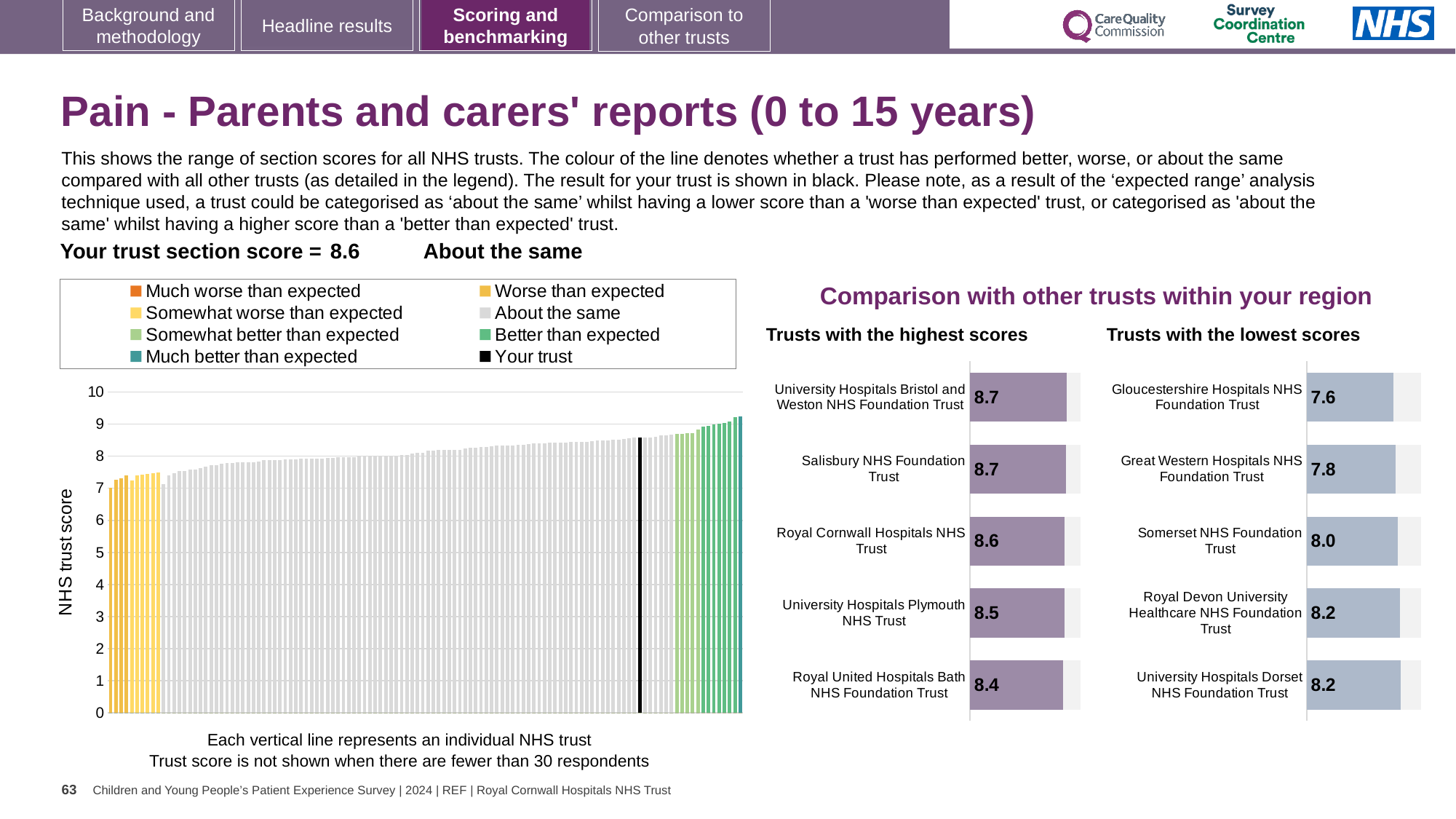
How many trusts are listed in the 'Trusts with the highest scores' chart? 5 In the 'Trusts with the highest scores' chart, what is the score for Royal United Hospitals Bath NHS Foundation Trust? 8.4 In the large chart on the left, do the trust scores rise or fall from left to right along the x axis? Rise In the 'Trusts with the lowest scores' chart, what is the score for Gloucestershire Hospitals NHS Foundation Trust? 7.6 In the large chart on the left, what is the section score for your trust (shown in black)? 8.6 In the 'Trusts with the lowest scores' chart, which trust has the lowest score? Gloucestershire Hospitals NHS Foundation Trust In the 'Trusts with the highest scores' chart, what is the difference between the score for Salisbury NHS Foundation Trust and the score for University Hospitals Plymouth NHS Trust? 0.2 What is the label on the y axis of the large chart on the left? NHS trust score How many entries does the legend above the large chart on the left list? 8 In the 'Trusts with the lowest scores' chart, which is larger: the score for Great Western Hospitals NHS Foundation Trust or the score for Somerset NHS Foundation Trust? Somerset NHS Foundation Trust In the 'Trusts with the lowest scores' chart, what is the difference between the score for University Hospitals Dorset NHS Foundation Trust and the score for Gloucestershire Hospitals NHS Foundation Trust? 0.6 What kind of chart is the large chart on the left showing NHS trust scores? Bar chart